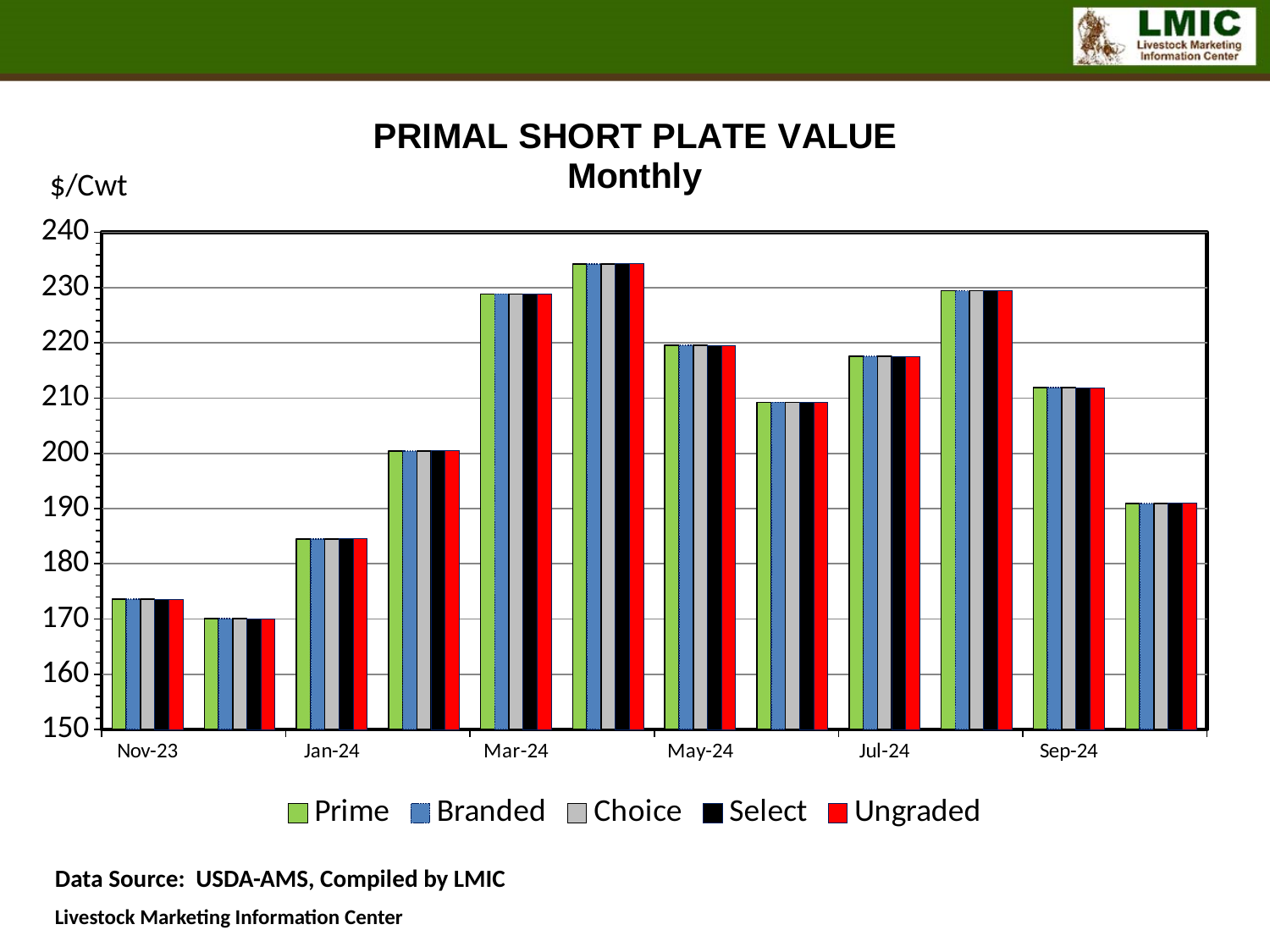
Which month has the larger Prime value, Jan-24 or Mar-24? Mar-24 Is the Choice value for Mar-24 greater or less than 220? greater Which month has the larger Ungraded value, Nov-23 or Sep-24? Sep-24 Do the values rise or fall from Jan-24 to Mar-24? rise Is the Select value for Jul-24 greater or less than 220? less Is the Prime value for Nov-23 greater or less than 170? greater What is the title of the chart? PRIMAL SHORT PLATE VALUE Monthly How many series does the legend list? 5 What unit is shown on the y axis of the chart? $/Cwt What kind of chart is shown on the slide? bar chart